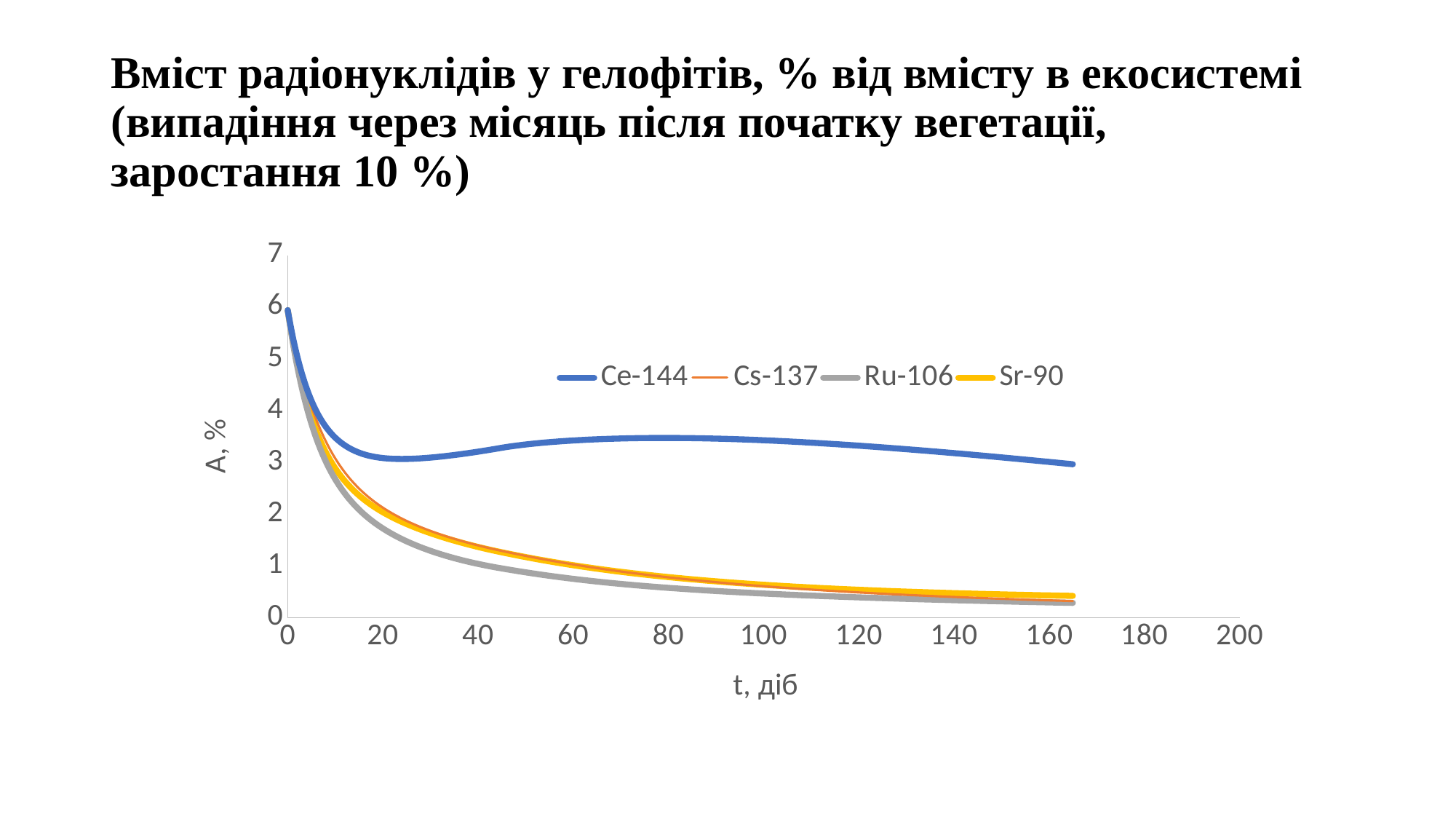
Is the value for Ce-144 at t = 160 greater or less than 2? greater Which series are listed in the legend? Ce-144, Cs-137, Ru-106, Sr-90 Is the value for Ru-106 at t = 100 greater or less than 1? less What kind of chart is shown on the slide? line chart Which series has the lowest value at t = 60? Ru-106 Is the value for Ce-144 at t = 80 greater or less than 3? greater How many series does the legend list? 4 Which series has the highest value at t = 160? Ce-144 At t = 100, which is larger: the value for Ce-144 or the value for Ru-106? Ce-144 What is the label of the x axis? t, діб